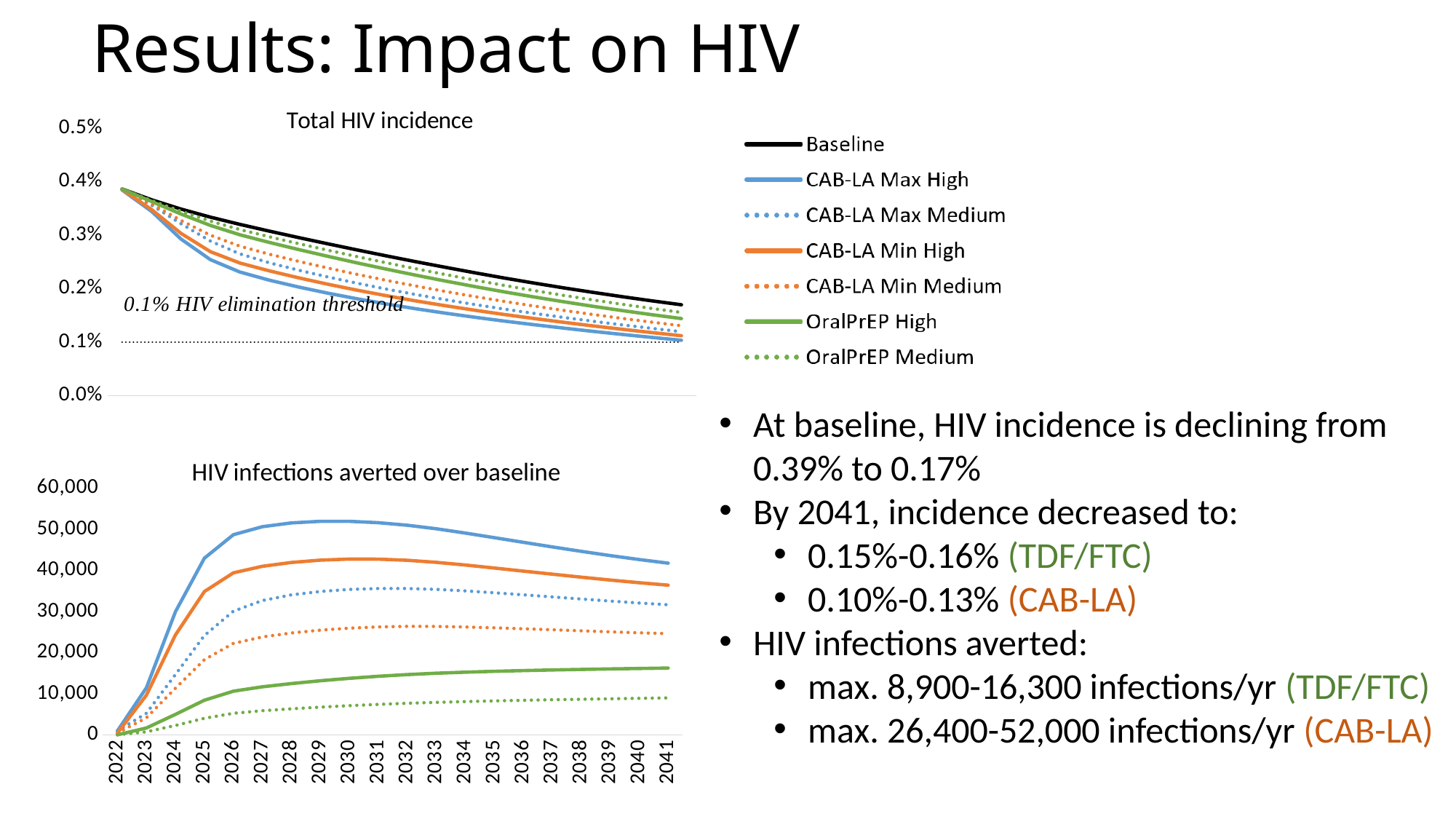
In the 'HIV infections averted over baseline' chart, which is larger in 2041: CAB-LA Min High or CAB-LA Max Medium? CAB-LA Min High In the 'Total HIV incidence' chart, is the Baseline value in 2041 greater or less than 0.2%? less What kind of chart is the 'Total HIV incidence' chart? Line chart How many years are shown on the x axis of the 'HIV infections averted over baseline' chart? 20 What threshold is marked by the dotted horizontal line in the 'Total HIV incidence' chart? 0.1% HIV elimination threshold In the 'Total HIV incidence' chart, does the Baseline series rise or fall from 2022 to 2041? Fall In the 'Total HIV incidence' chart, which series has the highest value in 2041? Baseline In the 'HIV infections averted over baseline' chart, is the value for OralPrEP High in 2041 greater or less than 20,000? less In the 'HIV infections averted over baseline' chart, which series has the lowest values? OralPrEP Medium How many series does the legend list for the charts? 7 In the 'HIV infections averted over baseline' chart, which series reaches the highest values? CAB-LA Max High In the 'HIV infections averted over baseline' chart, is the value for CAB-LA Max High in 2030 greater or less than 40,000? greater